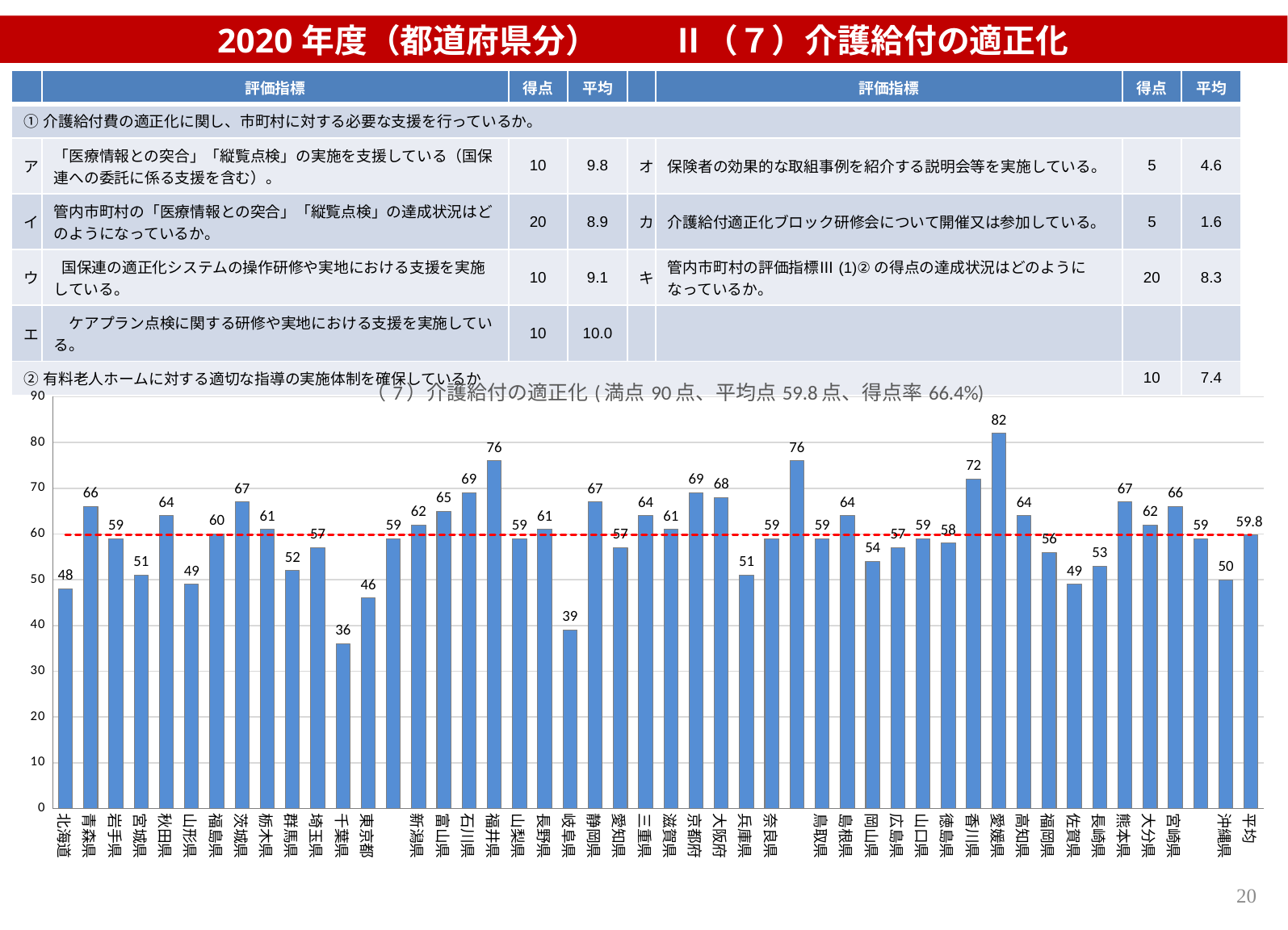
What is the value for 愛媛県? 82 What type of chart is shown on the slide? bar chart Which has a larger value, 京都府 or 大阪府? 京都府 What is the value shown for 平均 (the last bar)? 59.8 Is the value for 岐阜県 greater or less than 40? less What is the value for 福井県? 76 What is the difference between the values for 香川県 and 高知県? 8 Which prefecture has the lowest value? 千葉県 What is the difference between the values for 愛媛県 and 千葉県? 46 What is the maximum value shown on the vertical axis? 90 Which prefecture has the highest value? 愛媛県 What is the value for 千葉県? 36